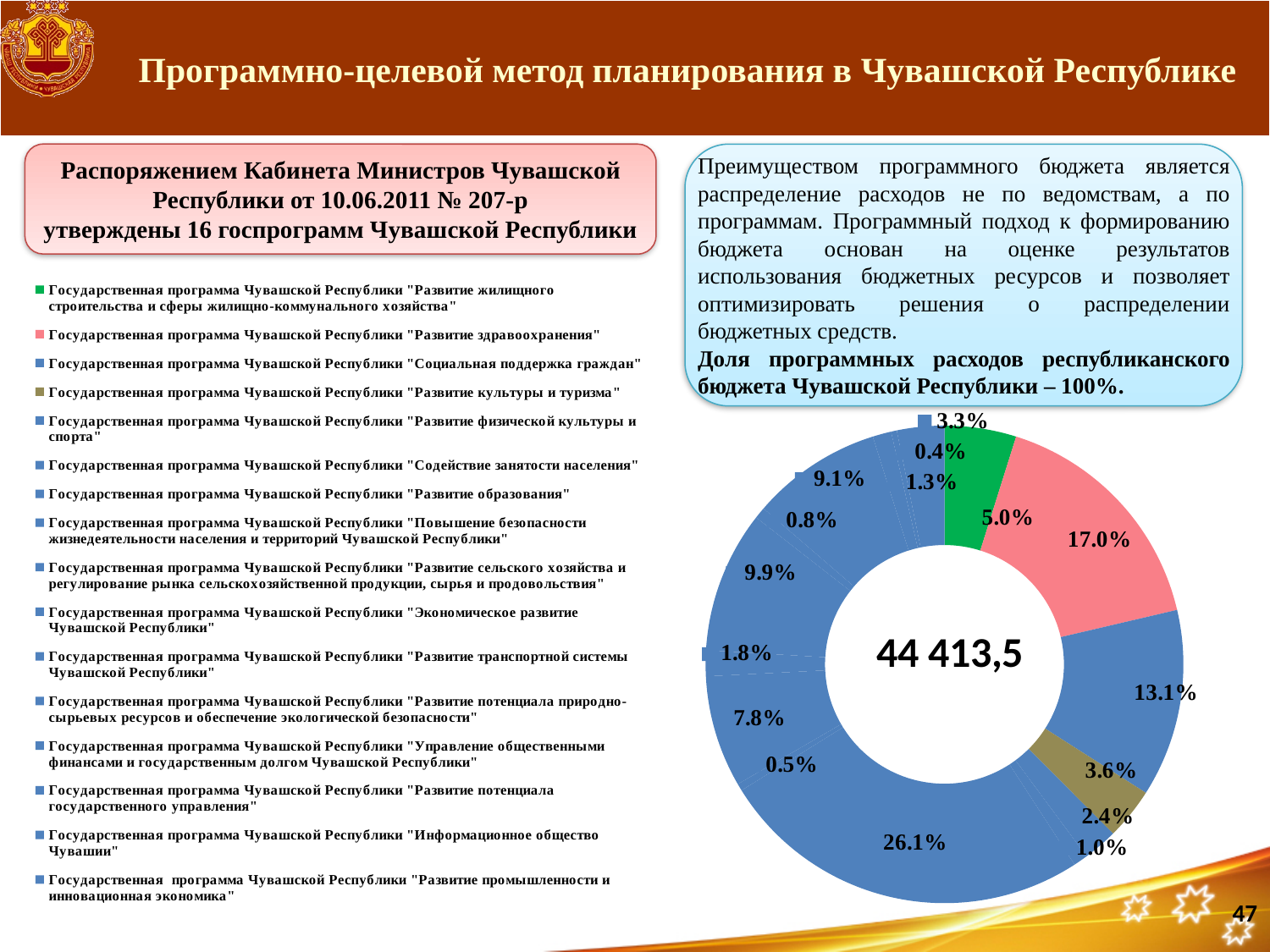
What share is shown for the olive-coloured slice (the programme "Развитие культуры и туризма")? 3.6% How many state programmes are listed in the legend on the left of the slide? 16 What is the combined share of the two largest slices (26.1% and 17.0%)? 43.1% What share is shown for the green slice (the programme "Развитие жилищного строительства и сферы жилищно-коммунального хозяйства")? 5.0% What value is printed in the centre of the doughnut chart? 44 413,5 What share is shown for the pink slice (the programme "Развитие здравоохранения")? 17.0% How many slices does the doughnut chart have? 16 Which is larger on the doughnut chart: the slice labelled 9.9% or the slice labelled 9.1%? 9.9% What is the smallest share shown on the doughnut chart? 0.4% What is the largest share shown on the doughnut chart? 26.1% What kind of chart is shown on the slide? Doughnut (pie) chart What is the difference between the pink slice (17.0%) and the green slice (5.0%)? 12.0%